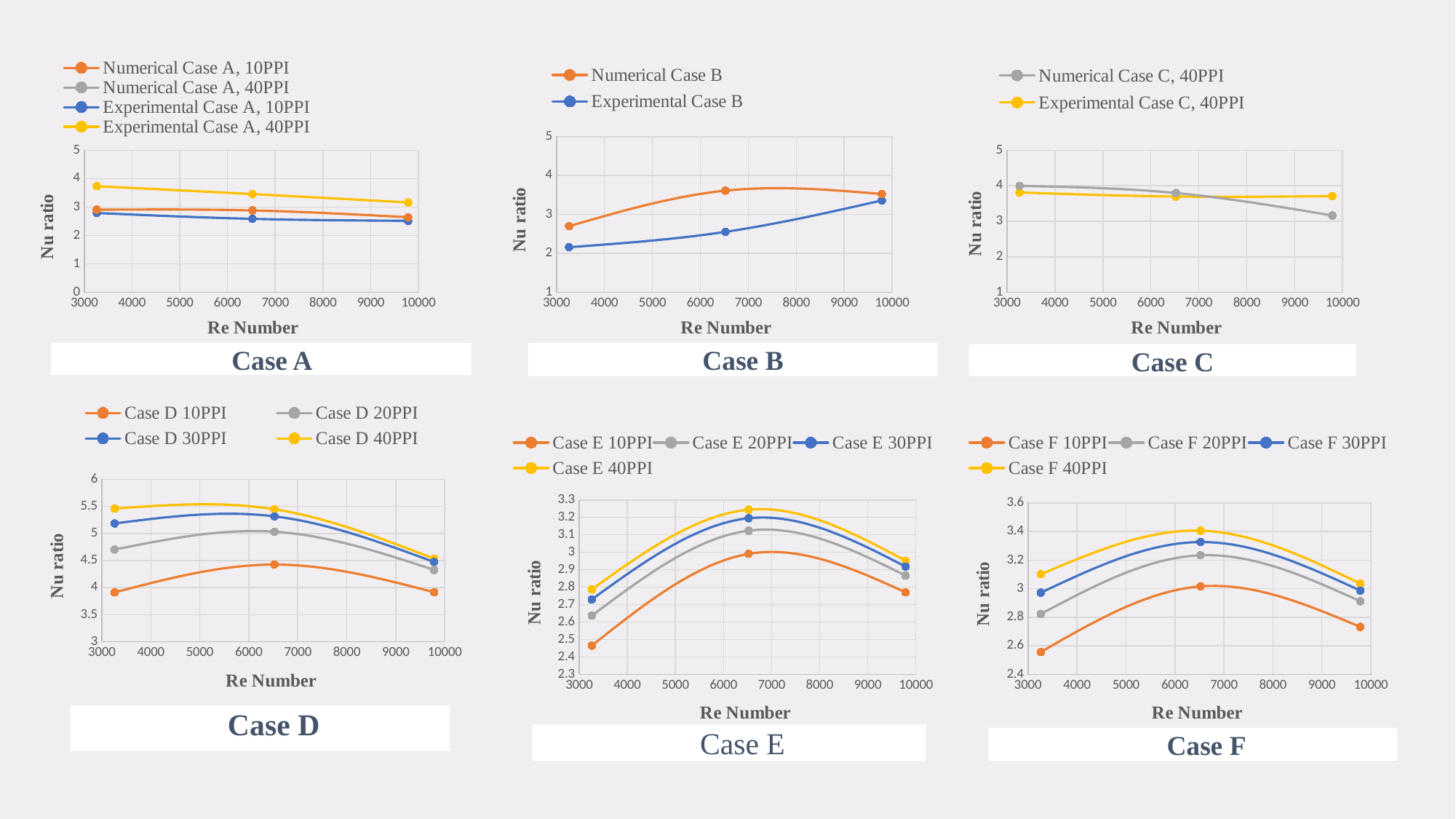
On the Case E chart, how many series does the legend list? 4 On the Case A chart, how many series does the legend list? 4 On the Case D chart, how many data points does each series have? 3 On the Case D chart, which series has the highest Nu ratio values? Case D 40PPI How many charts are shown on the slide? 6 On the Case B chart, at the lowest Re Number, which series has the larger Nu ratio: Numerical Case B or Experimental Case B? Numerical Case B On the Case F chart, which series has the lowest Nu ratio values? Case F 10PPI On the Case C chart, at the highest Re Number, which series has the larger Nu ratio: Numerical Case C, 40PPI or Experimental Case C, 40PPI? Experimental Case C, 40PPI On the Case B chart, does the Experimental Case B series rise or fall as the Re Number increases? Rises On the Case D chart, is the Nu ratio for Case D 10PPI at the lowest Re Number greater or less than 4? less On the Case C chart, does the Numerical Case C, 40PPI series rise or fall as the Re Number increases? Falls What kind of chart is the Case B chart? Line chart